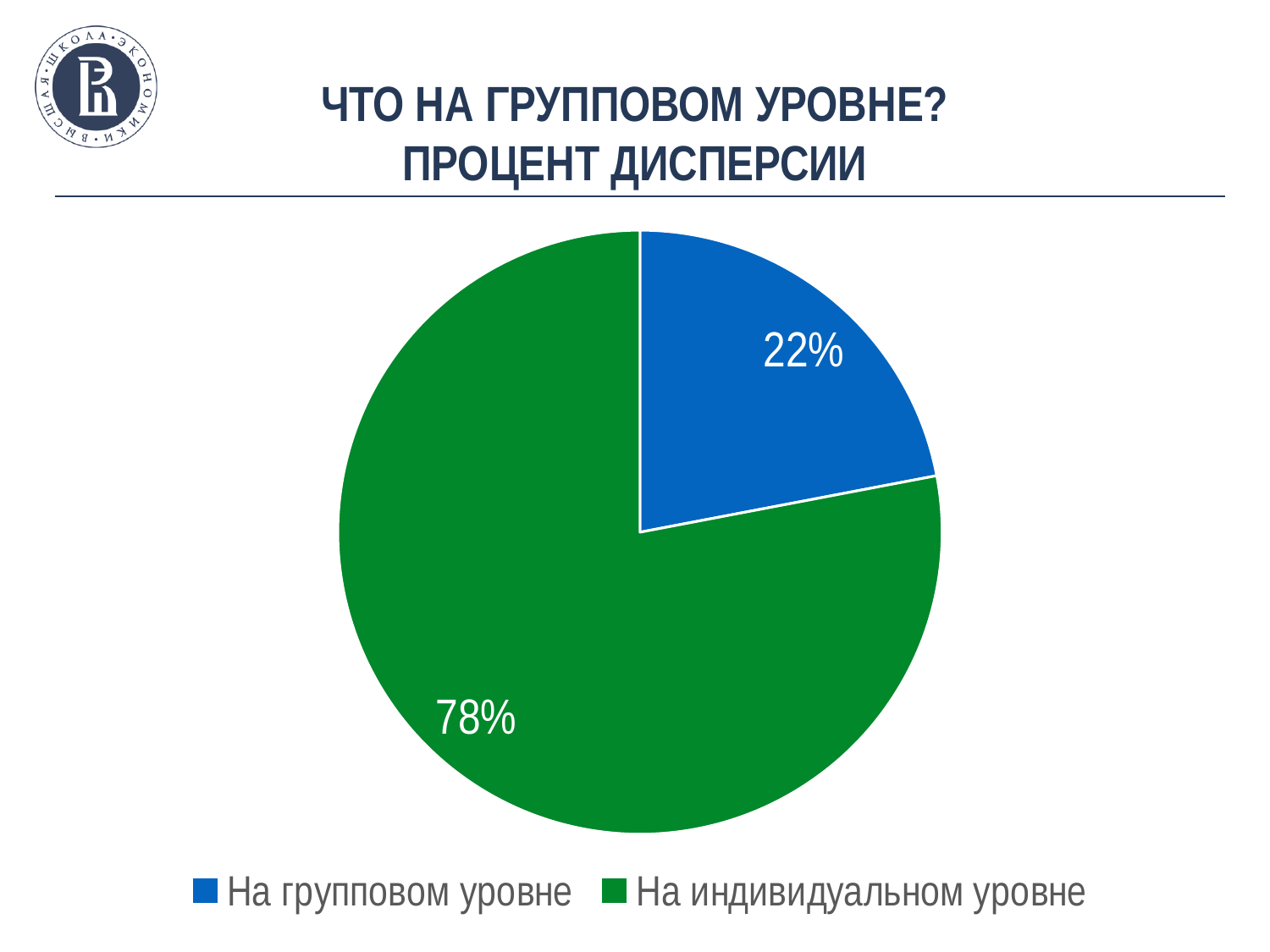
Which slice is the largest? На индивидуальном уровне What share of the pie does "На групповом уровне" take? 22% What colour is the "На групповом уровне" slice? blue What percentage is shown for "На групповом уровне"? 22% What kind of chart is shown on the slide? pie chart What percentage is shown for "На индивидуальном уровне"? 78% What is the difference between the "На индивидуальном уровне" and "На групповом уровне" slices? 56% What colour is the "На индивидуальном уровне" slice? green Which slice is the smallest? На групповом уровне Which is larger: "На групповом уровне" or "На индивидуальном уровне"? На индивидуальном уровне How many slices does the pie chart have? 2 How many entries does the legend list? 2